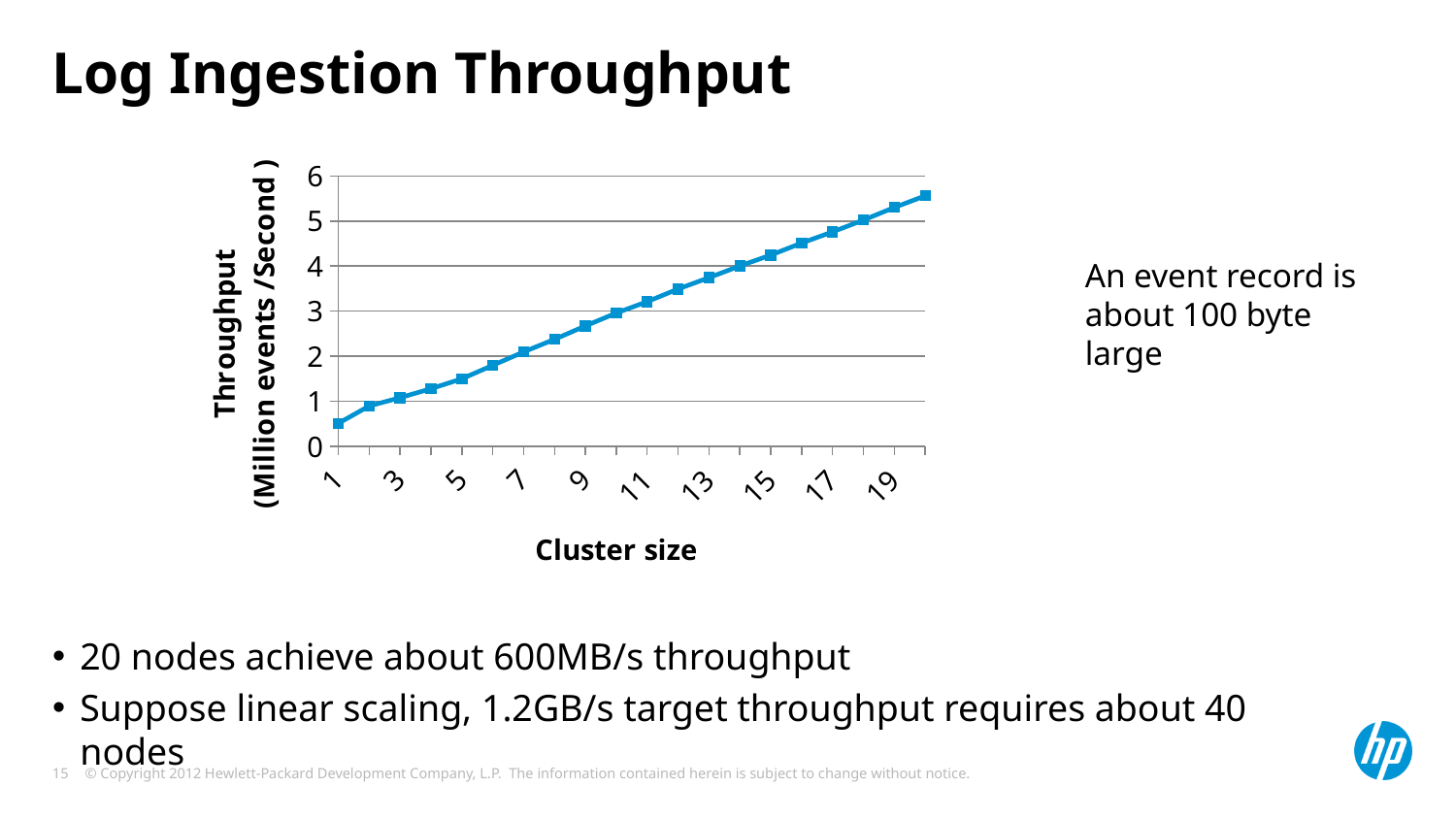
What kind of chart is shown on the slide? line chart Is the throughput for cluster size 1 greater or less than 1? less Which cluster size has the highest throughput? 20 What is the label of the y axis? Throughput (Million events /Second ) Which has the higher throughput, cluster size 5 or cluster size 15? cluster size 15 Do the throughput values rise or fall as cluster size increases? rise What is the label of the x axis? Cluster size Which cluster size has the lowest throughput? 1 Is the throughput for cluster size 9 greater or less than 3? less Is the throughput for cluster size 13 greater or less than 3? greater